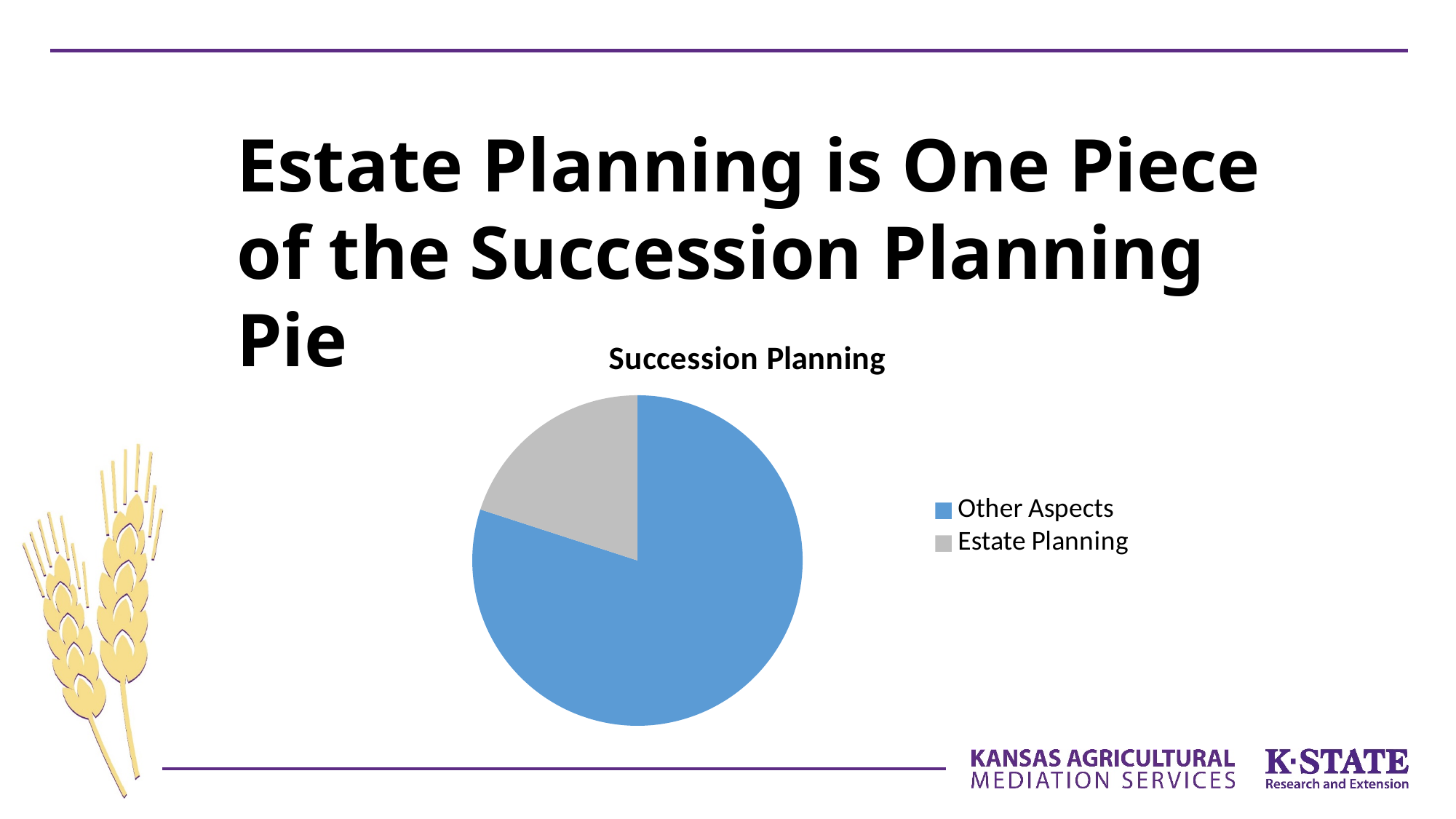
What colour is the Estate Planning slice? grey Which is larger, the Other Aspects slice or the Estate Planning slice? Other Aspects Which slice of the pie is the largest? Other Aspects What kind of chart is shown on the slide? pie chart How many slices does the pie chart have? 2 What is the title of the chart? Succession Planning Which slice of the pie is the smallest? Estate Planning How many entries does the legend list? 2